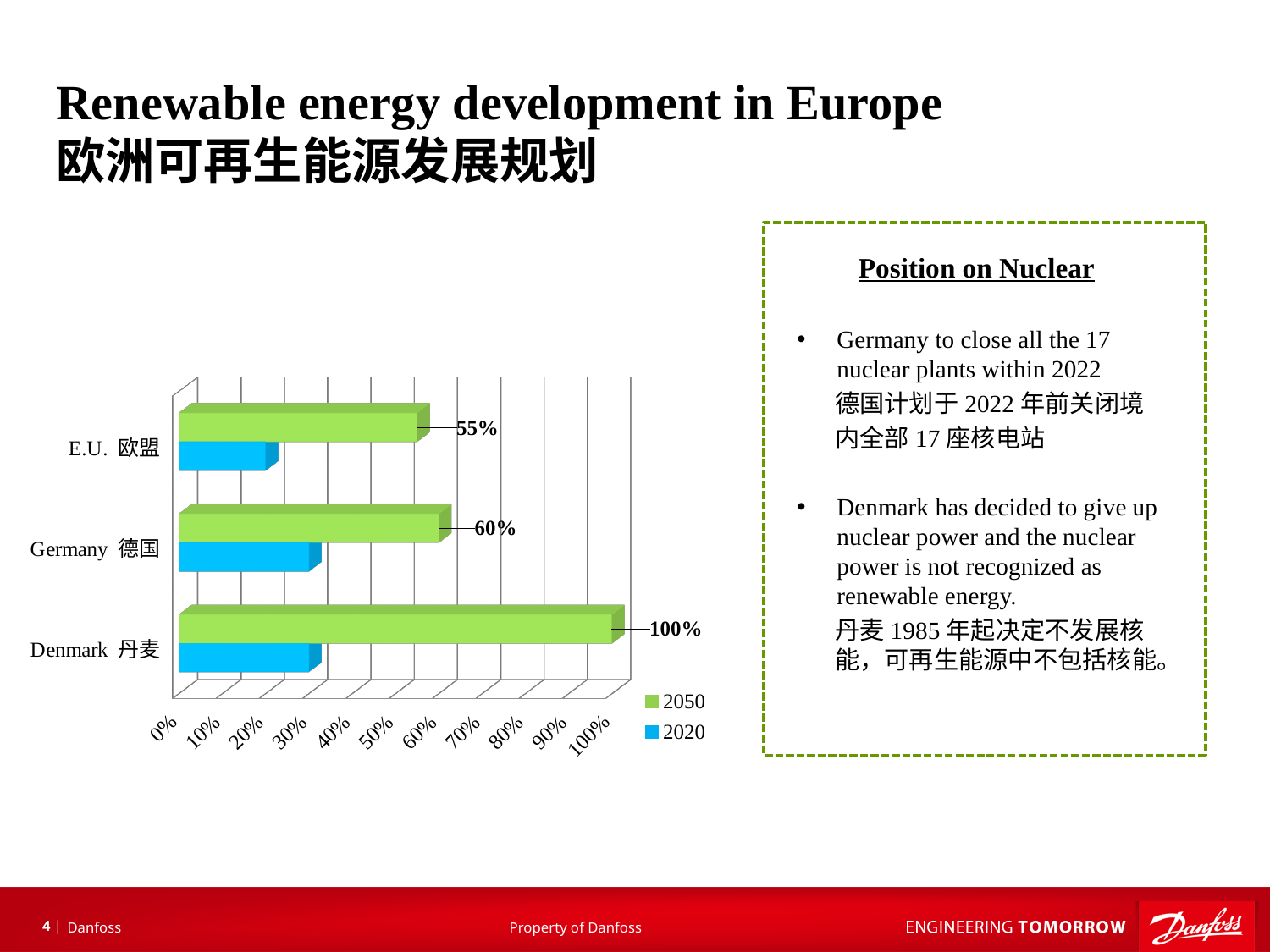
What is the 2050 value for E.U.? 55% What is the 2050 value for Germany? 60% Is the 2020 value for Denmark greater or less than 50%? less What is the difference between the 2050 values for Denmark and E.U.? 45% Which is larger, the 2050 value for Germany or the 2050 value for E.U.? Germany Which category has the lowest 2050 value? E.U. Which category has the highest 2050 value? Denmark How many series does the legend list? 2 What is the 2050 value for Denmark? 100% Is the 2020 value for E.U. greater or less than 30%? less What kind of chart is shown on the slide? Bar chart How many categories are shown in the chart? 3